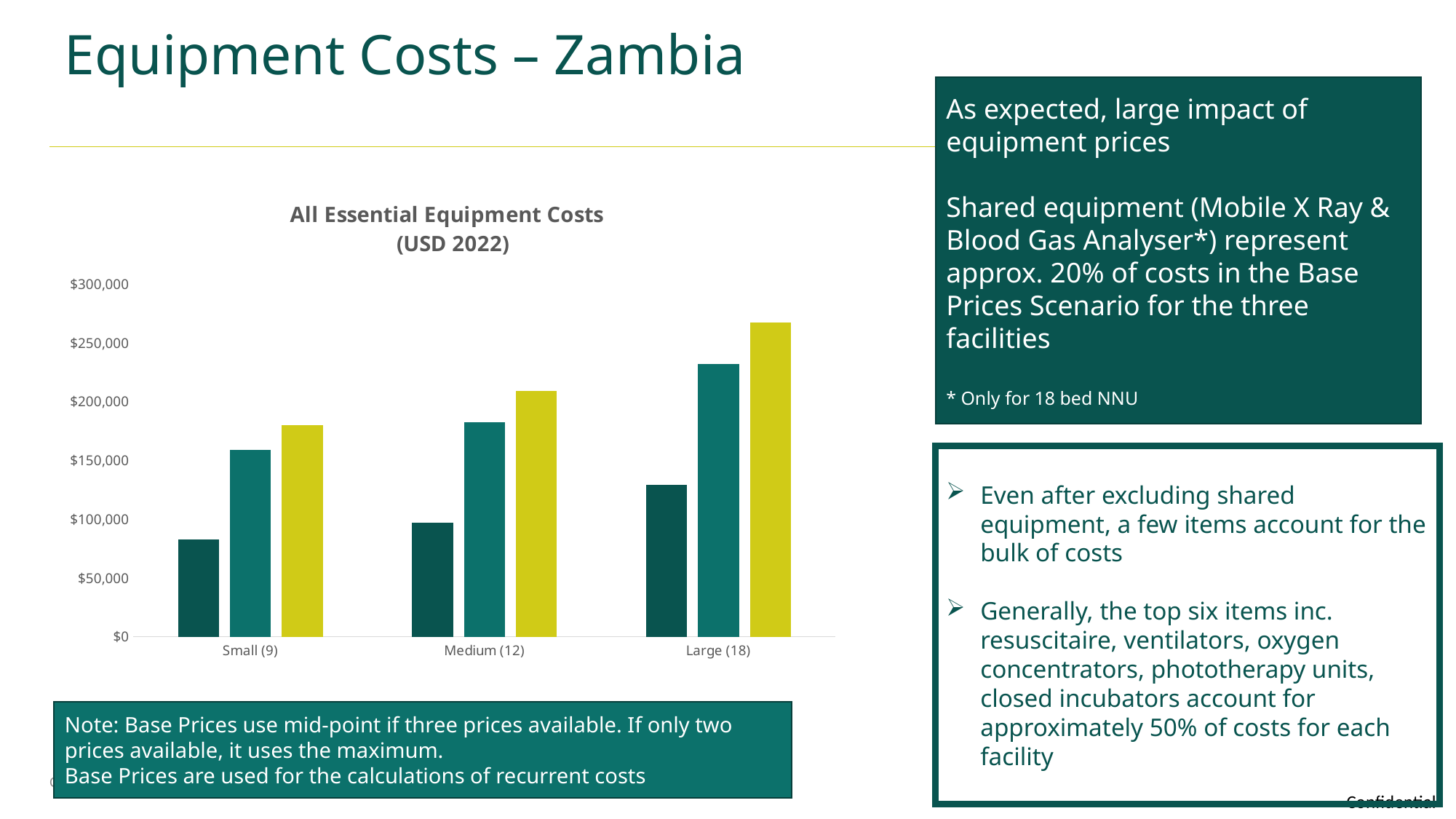
Which is larger: the dark green bar for Large (18) or the dark green bar for Small (9)? Large (18) Is the value of the teal bar for Medium (12) greater or less than $150,000? greater How many bars are plotted for each facility size category? 3 What kind of chart is shown on the slide? bar chart Which facility size category has the tallest bars in the chart? Large (18) Which facility size category has the shortest bars in the chart? Small (9) How many facility size categories are shown on the x axis of the chart? 3 Do the equipment costs rise or fall as facility size increases from Small (9) to Large (18)? rise What is the title of the chart? All Essential Equipment Costs (USD 2022) Is the value of the teal bar for Large (18) greater or less than $200,000? greater Is the value of the yellow-green bar for Large (18) greater or less than $250,000? greater